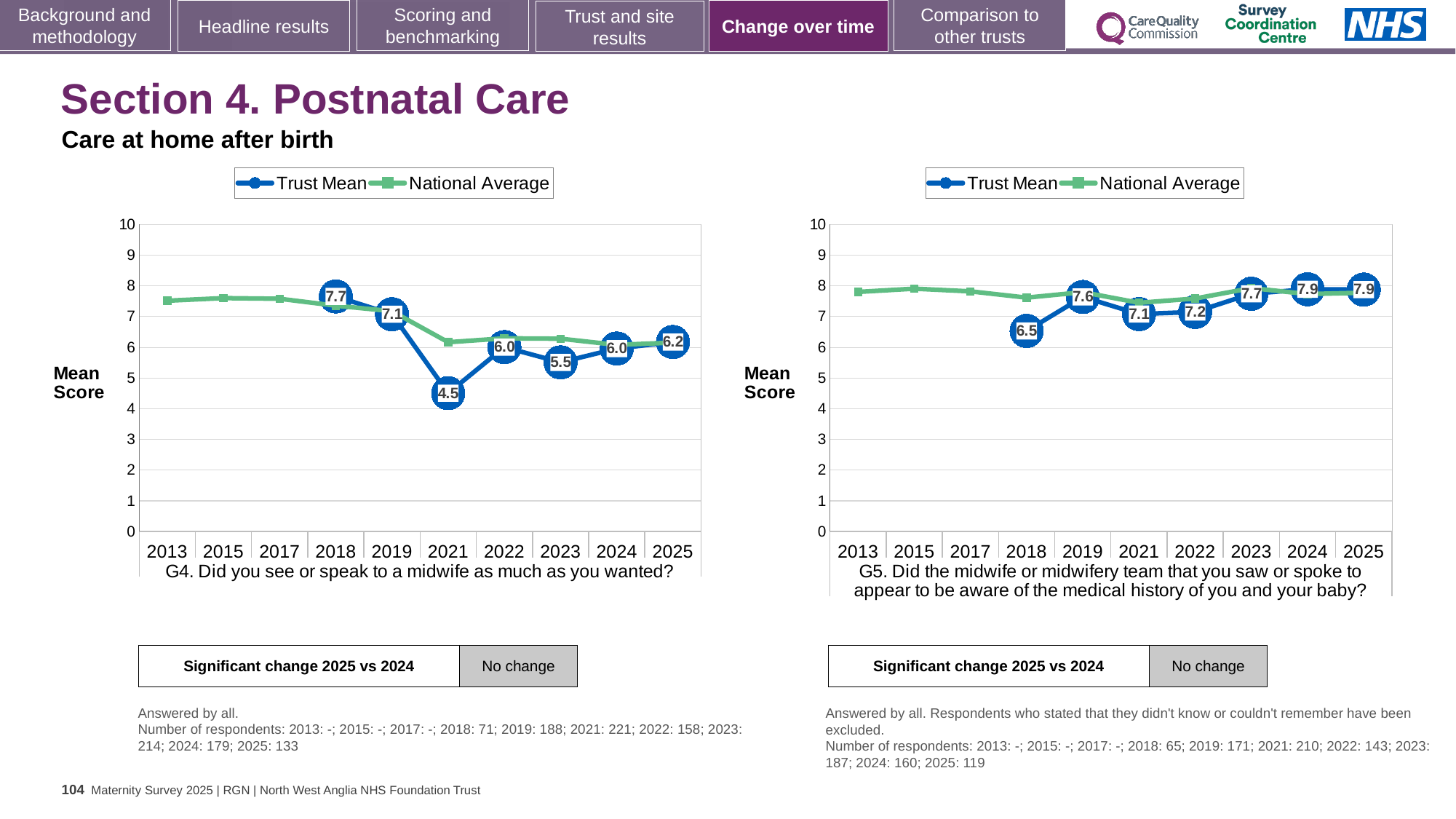
What kind of chart is the G4 chart on the left? Line chart In the G5 chart on the right, what is the difference between the Trust Mean values for 2025 and 2018? 1.4 In the G5 chart on the right, what is the Trust Mean value for 2018? 6.5 In the G5 chart on the right, is the Trust Mean value for 2019 or 2021 larger? 2019 In the G4 chart on the left, what is the difference between the Trust Mean values for 2018 and 2021? 3.2 In the G4 chart on the left, is the National Average value for 2013 greater or less than 7? greater In the G4 chart on the left, which year has the lowest labelled Trust Mean value? 2021 How many series does the legend of the G5 chart on the right list? 2 In the G4 chart on the left, which year has the highest labelled Trust Mean value? 2018 In the G5 chart on the right, which year has the lowest labelled Trust Mean value? 2018 How many years are shown on the x axis of the G4 chart on the left? 10 In the G4 chart on the left, what is the Trust Mean value for 2021? 4.5